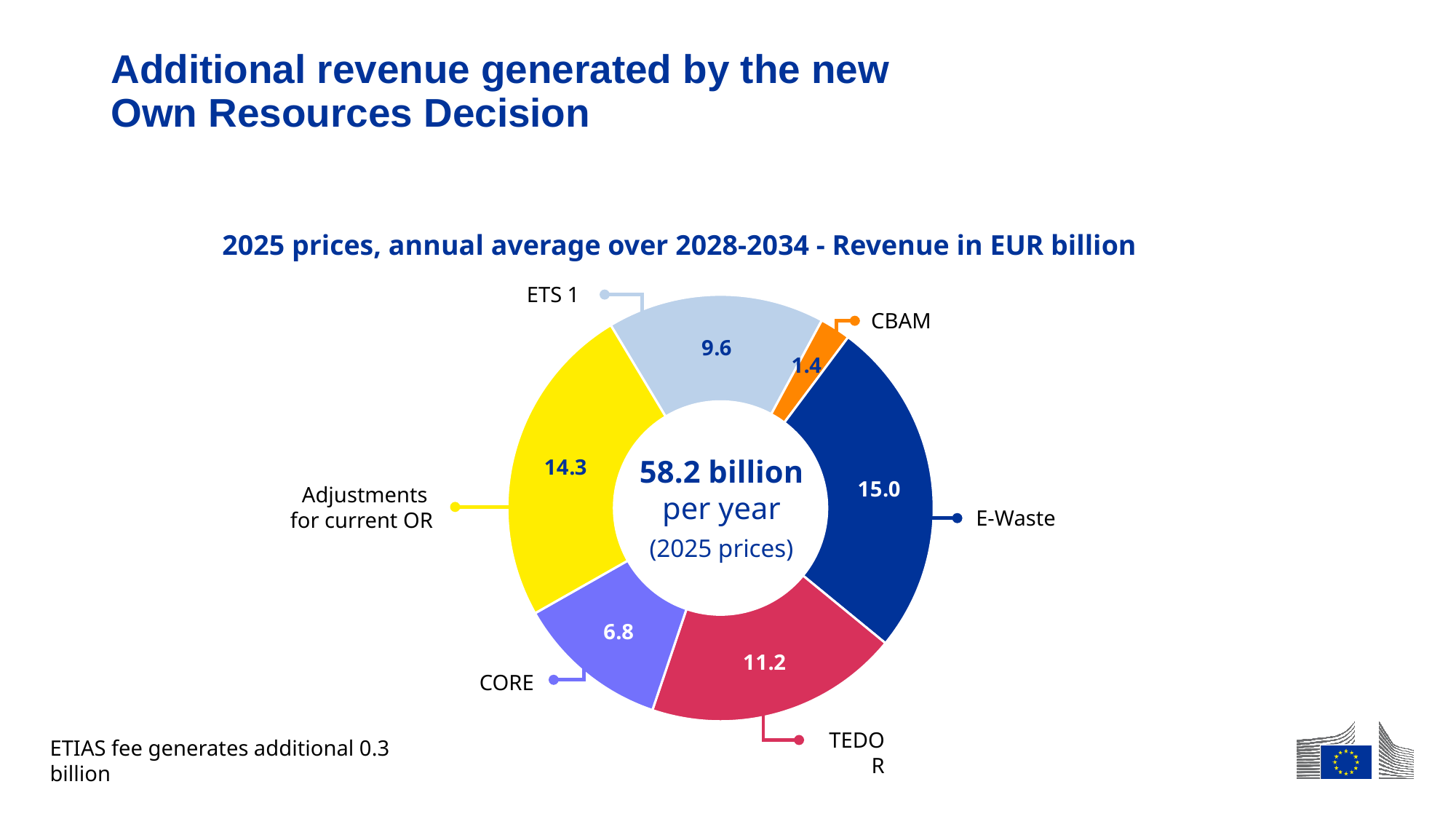
Which category has the highest value? E-Waste How many categories are shown in the chart? 6 Which is larger, the value for TEDOR or the value for CORE? TEDOR What is the value for Adjustments for current OR? 14.3 What is the value for E-Waste? 15.0 Which category has the lowest value? CBAM What is the value for ETS 1? 9.6 What is the difference between the values for E-Waste and CBAM? 13.6 What is the difference between the values for Adjustments for current OR and ETS 1? 4.7 What kind of chart is shown on the slide? Pie chart (donut) What total is printed in the centre of the chart? 58.2 billion per year What is the value for CORE? 6.8